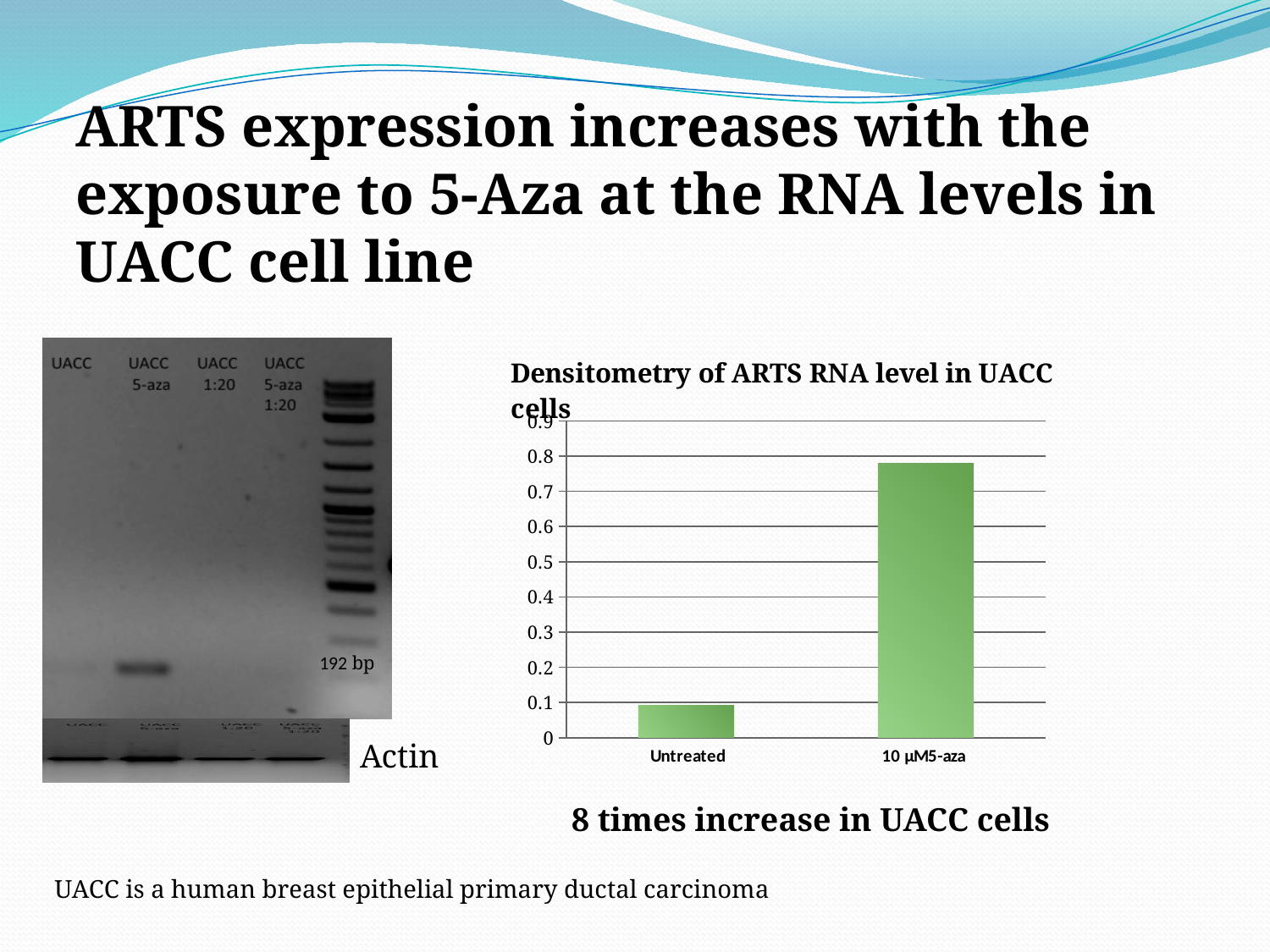
Do the values rise or fall from Untreated to 10 µM5-aza along the x axis? rise What is the title of the chart? Densitometry of ARTS RNA level in UACC cells What kind of chart is shown on the slide? bar chart Is the value for 10 µM5-aza greater or less than 0.7? greater Is the value for 10 µM5-aza greater or less than 0.8? less Which is larger, the value for Untreated or the value for 10 µM5-aza? 10 µM5-aza Is the value for Untreated greater or less than 0.5? less What is the highest tick value shown on the y axis of the chart? 0.9 Which category has the highest bar in the chart? 10 µM5-aza How many categories are plotted on the x axis of the chart? 2 Which category has the lowest bar in the chart? Untreated